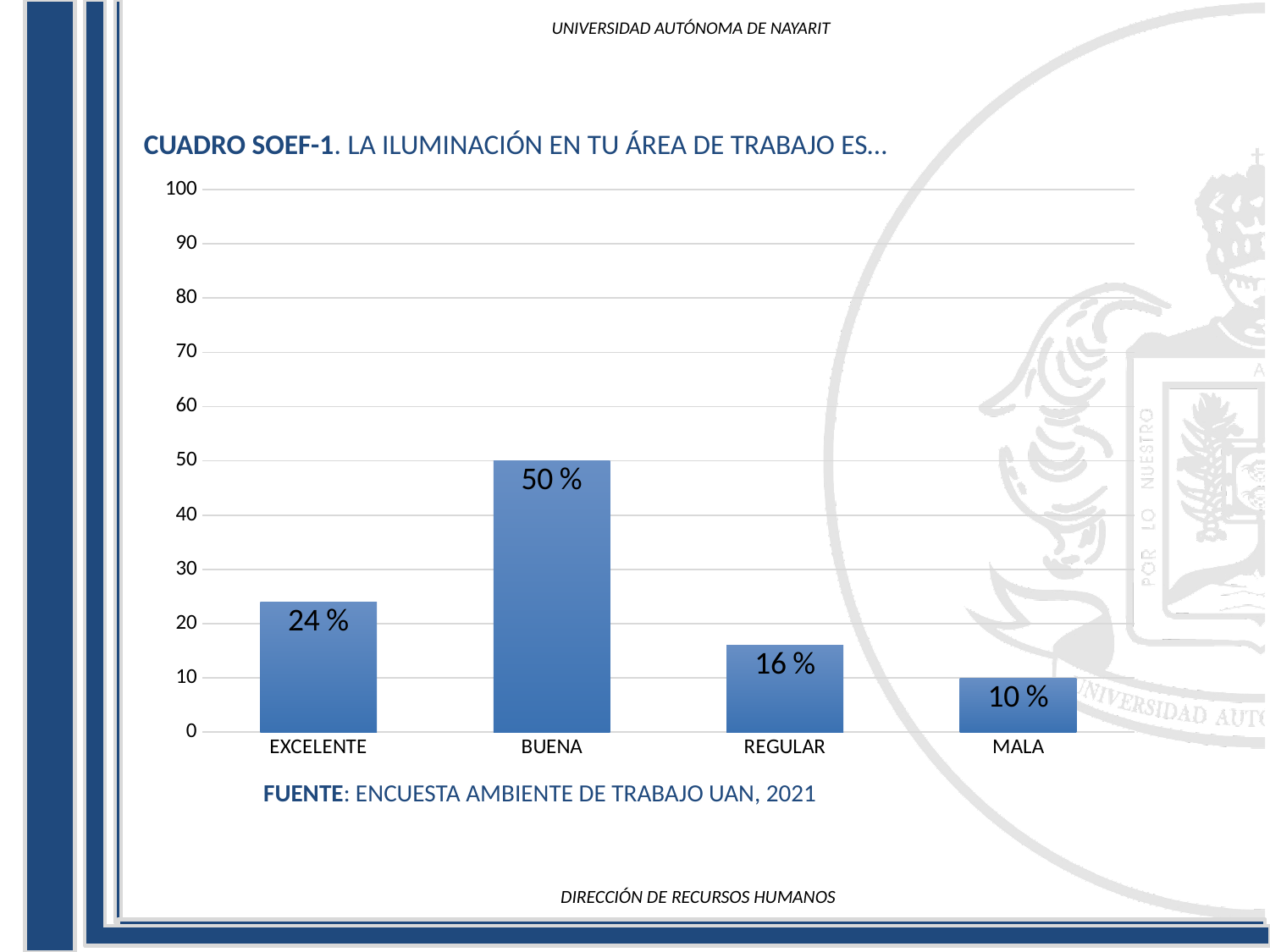
What kind of chart is shown on the slide? Bar chart What is the value for MALA? 10 % What is the difference between the values for BUENA and EXCELENTE? 26 % What is the difference between the values for REGULAR and MALA? 6 % Which is larger, the value for EXCELENTE or the value for REGULAR? EXCELENTE Which category has the highest value? BUENA How many categories are shown on the x axis? 4 What is the value for BUENA? 50 % What is the source cited below the chart? ENCUESTA AMBIENTE DE TRABAJO UAN, 2021 Which category has the lowest value? MALA What is the value for EXCELENTE? 24 % What is the value for REGULAR? 16 %